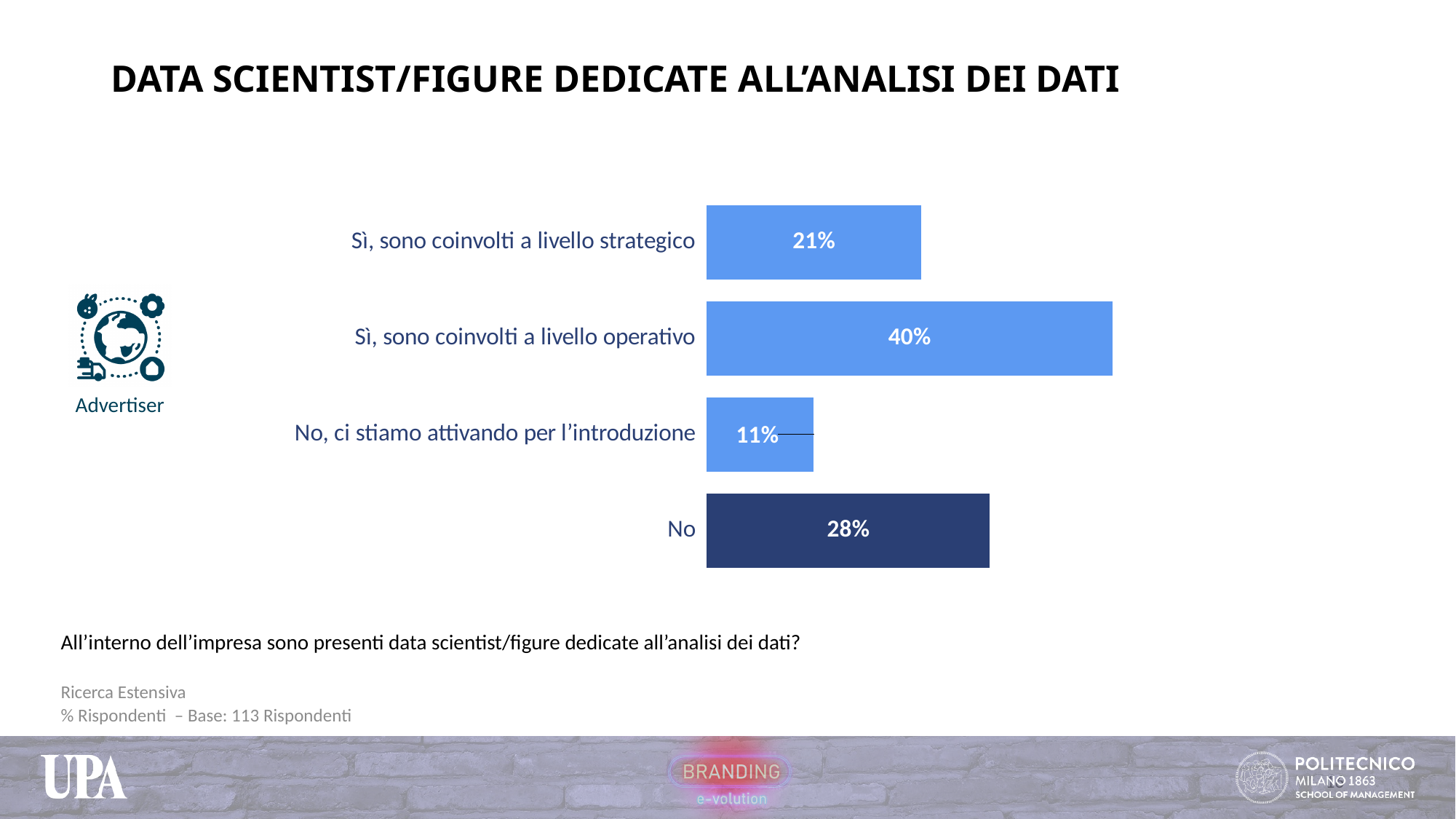
What kind of chart is shown on the slide? Bar chart What is the value for "Sì, sono coinvolti a livello strategico"? 21% Which category's bar is drawn in dark blue rather than light blue? No Which category has the lowest value? No, ci stiamo attivando per l'introduzione What is the difference between the values for "Sì, sono coinvolti a livello operativo" and "No"? 12% What is the difference between the values for "Sì, sono coinvolti a livello strategico" and "No, ci stiamo attivando per l'introduzione"? 10% What is the value for "Sì, sono coinvolti a livello operativo"? 40% Which category has the highest value? Sì, sono coinvolti a livello operativo How many categories are shown in the chart? 4 What is the value for "No, ci stiamo attivando per l'introduzione"? 11% Which is larger, the value for "No" or the value for "Sì, sono coinvolti a livello strategico"? No What is the value for "No"? 28%